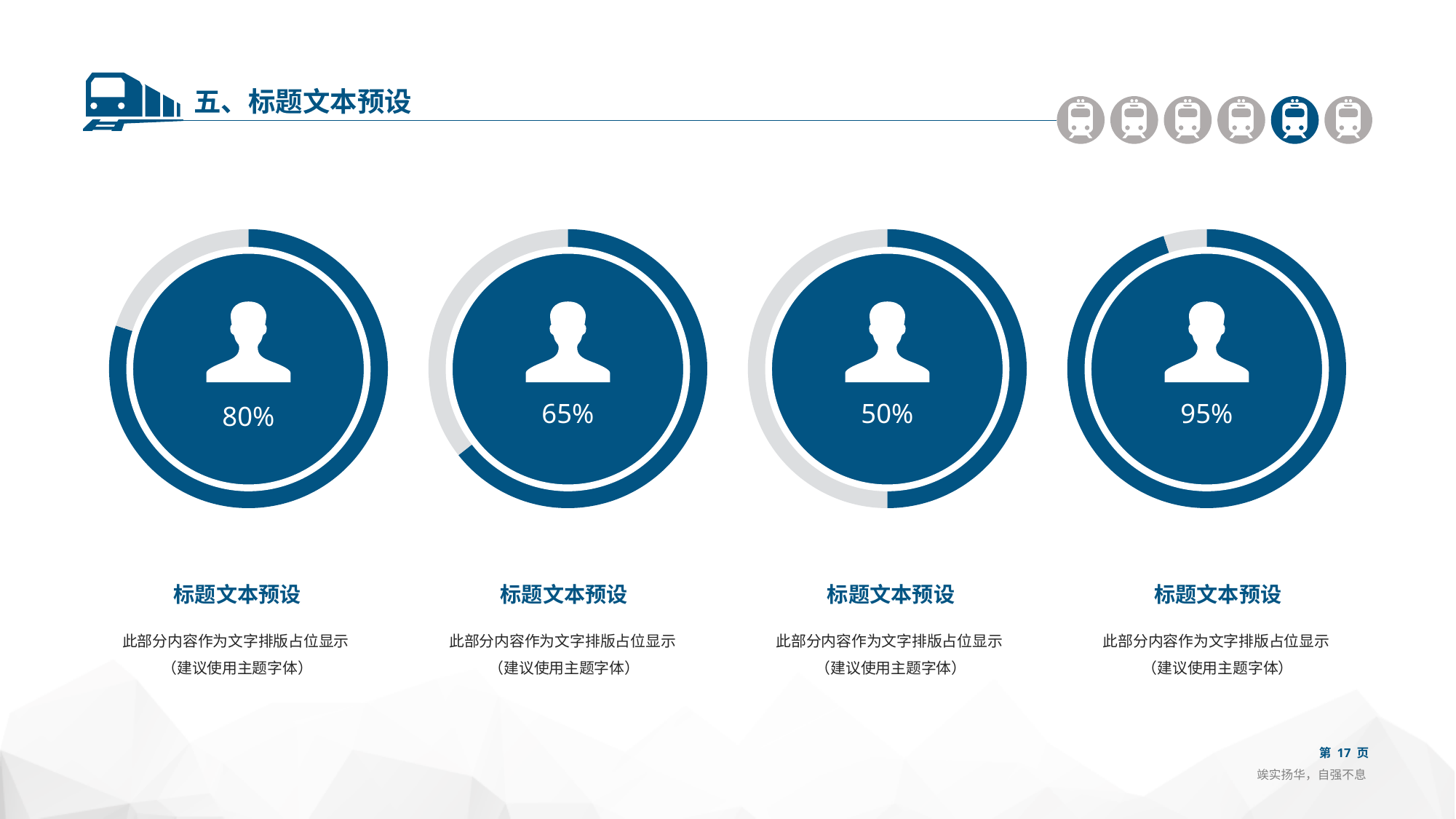
What value is shown in the first (leftmost) ring chart? 80% Which is larger, the value in the second ring chart or the value in the third ring chart? The second ring chart (65%) What kind of chart is used to display the percentages on the slide? Ring (donut) progress chart What is the difference between the value in the rightmost ring chart and the value in the leftmost ring chart? 15% Which ring chart shows the highest percentage? The fourth (rightmost), 95% What colour is the filled portion of each ring chart? Dark blue What value is shown in the third ring chart from the left? 50% What value is shown in the fourth (rightmost) ring chart? 95% What value is shown in the second ring chart from the left? 65% How many ring charts are shown on the slide? 4 What is the difference between the values in the first and second ring charts from the left? 15% Which ring chart shows the lowest percentage? The third from the left, 50%